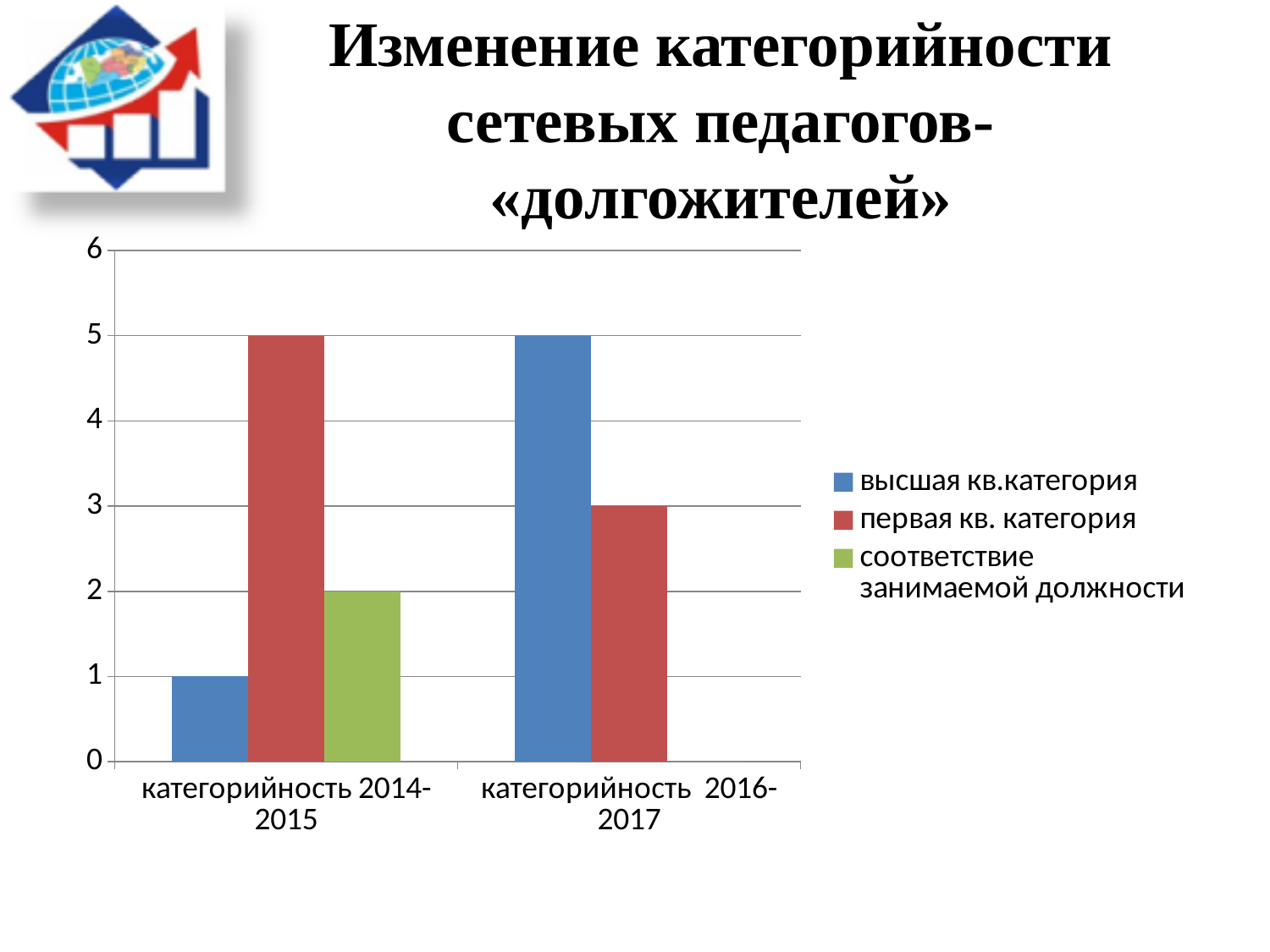
What is the value for «соответствие занимаемой должности» in «категорийность 2014-2015»? 2 Which series has the lowest value in «категорийность 2014-2015»? высшая кв.категория What is the value for «первая кв. категория» in «категорийность 2016-2017»? 3 Which series has the highest value in «категорийность 2014-2015»? первая кв. категория How many categories are shown on the x axis? 2 What kind of chart is shown on the slide? bar chart What is the value for «первая кв. категория» in «категорийность 2014-2015»? 5 Which is larger: «первая кв. категория» in «категорийность 2014-2015» or in «категорийность 2016-2017»? категорийность 2014-2015 How many series does the legend list? 3 What is the value for «высшая кв.категория» in «категорийность 2016-2017»? 5 What is the value for «высшая кв.категория» in «категорийность 2014-2015»? 1 What is the difference between «высшая кв.категория» in «категорийность 2016-2017» and in «категорийность 2014-2015»? 4